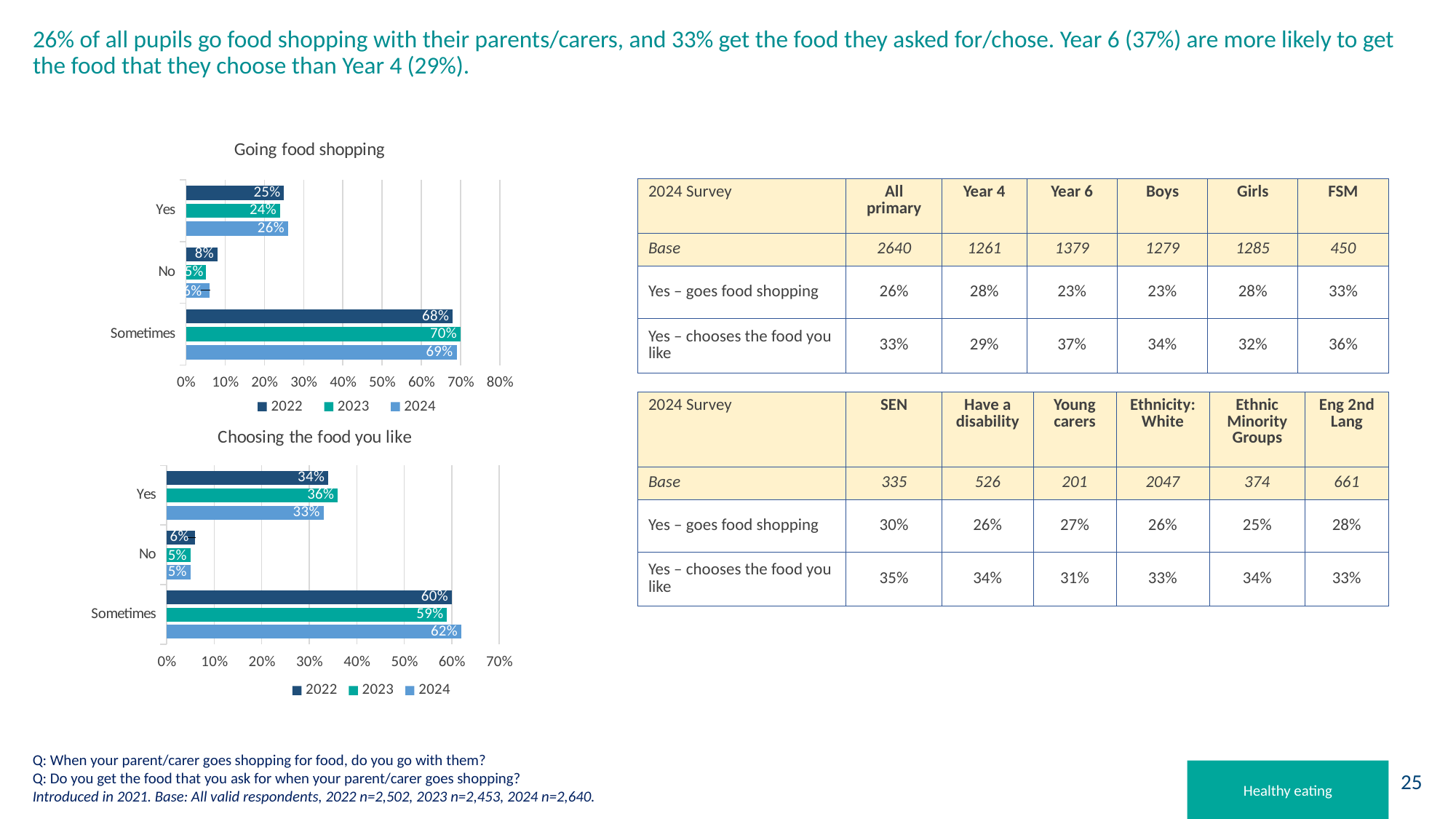
How many series does the legend of the 'Going food shopping' chart list? 3 In the 'Going food shopping' chart, what is the 2024 value for Yes? 26% In the 'Choosing the food you like' chart, what is the difference between the 2024 and 2023 values for Sometimes? 3% In the 'Choosing the food you like' chart, what is the 2023 value for Yes? 36% What kind of chart is the 'Choosing the food you like' chart? Bar chart In the 'Choosing the food you like' chart, what is the 2024 value for Sometimes? 62% In the 'Choosing the food you like' chart, which is larger for Yes: the 2022 value or the 2024 value? 2022 In the 'Choosing the food you like' chart, which category has the lowest value for 2024? No In the 'Going food shopping' chart, which category has the highest value for 2022? Sometimes In the 'Going food shopping' chart, what is the 2023 value for Sometimes? 70% In the 'Going food shopping' chart, what is the 2022 value for No? 8% In the 'Going food shopping' chart, what is the difference between the 2022 and 2023 values for Sometimes? 2%